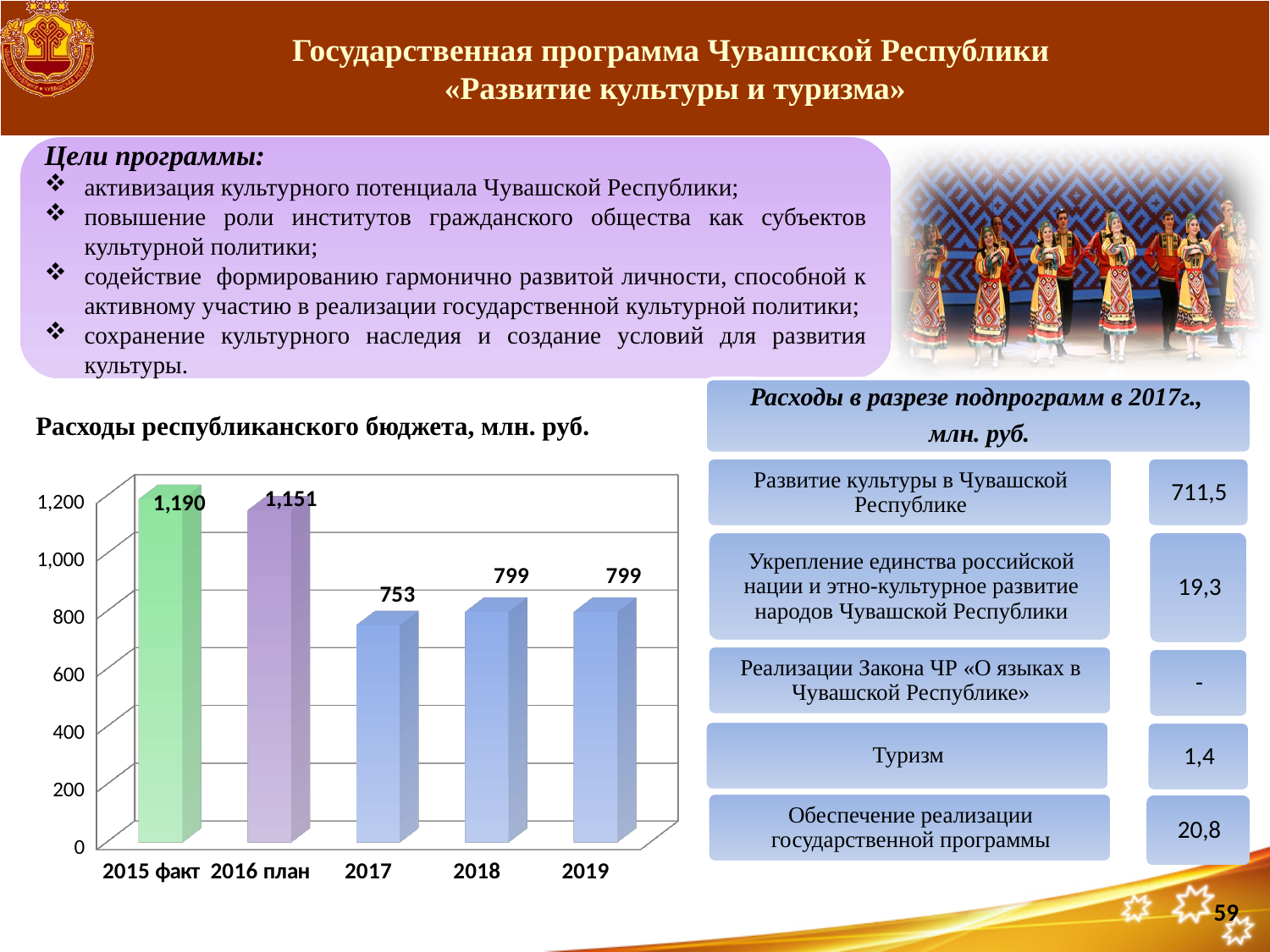
What is the title of the chart on the slide? Расходы республиканского бюджета, млн. руб. What is the value for 2015 факт in the chart 'Расходы республиканского бюджета, млн. руб.'? 1,190 What is the difference between the values for 2015 факт and 2016 план? 39 What is the difference between the values for 2018 and 2017? 46 How many categories are shown on the x axis of the chart? 5 Which category has the lowest value in the chart? 2017 What kind of chart is shown on the slide? Bar chart What is the value for 2019 in the chart? 799 What is the value for 2017 in the chart? 753 What is the value for 2016 план in the chart? 1,151 Which category has the highest value in the chart? 2015 факт Which is larger, the value for 2016 план or the value for 2018? 2016 план